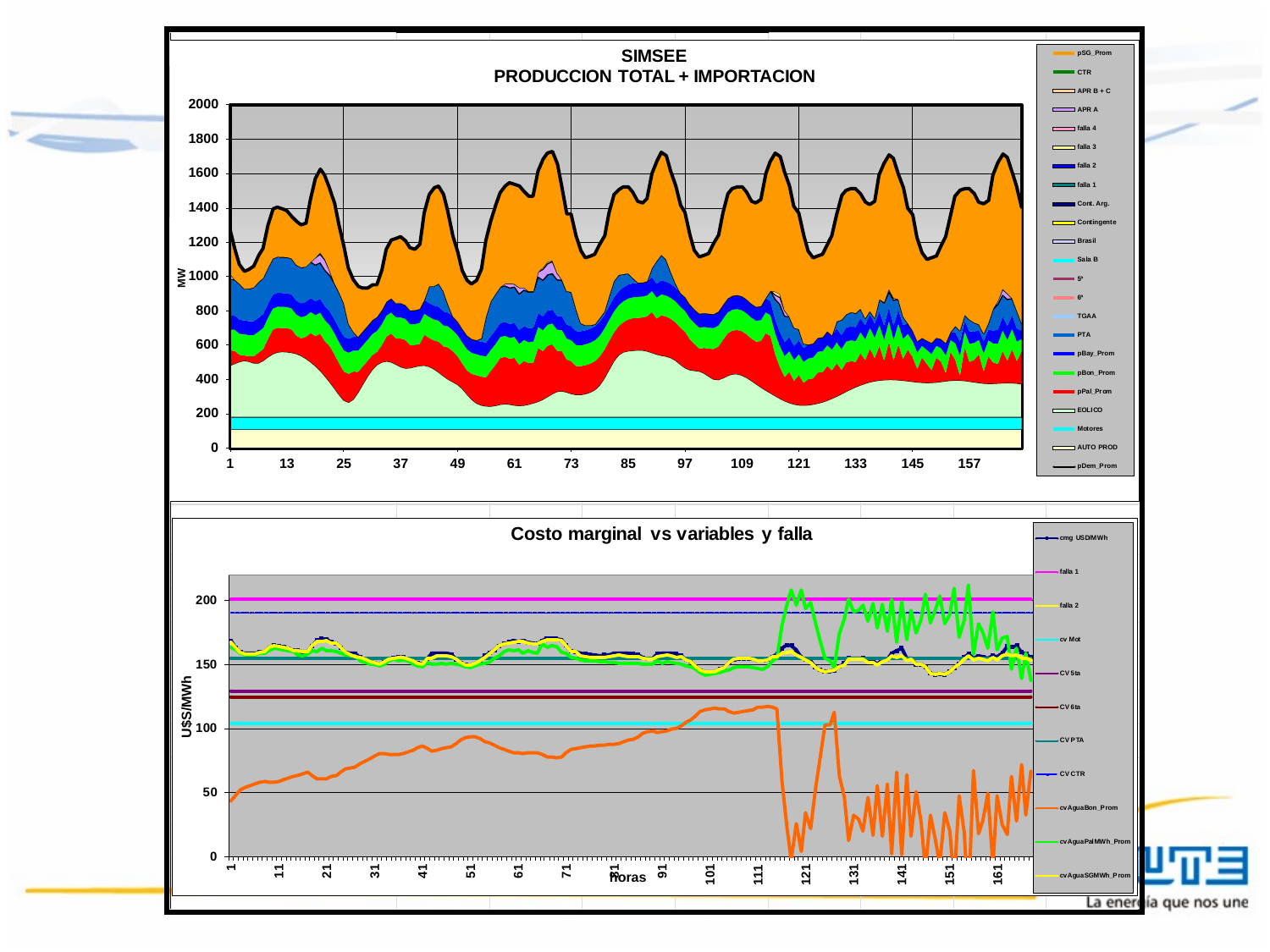
What kind of chart is the top chart titled "SIMSEE PRODUCCION TOTAL + IMPORTACION"? stacked area chart In the bottom chart, does the cvAguaBon_Prom line rise or fall between hour 1 and hour 111? rise In the bottom chart, is the value of cvAguaBon_Prom at hour 1 greater or less than 50? less How many series does the legend of the bottom chart list? 11 In the bottom chart, is the value of the CV CTR line greater or less than 150? greater What is the y-axis label of the bottom chart? US$/MWh How many series does the legend of the top chart list? 23 In the top chart, is the highest value of the pDem_Prom line greater or less than 1800? less What kind of chart is the bottom chart titled "Costo marginal vs variables y falla"? line chart What is the y-axis label of the top chart? MW